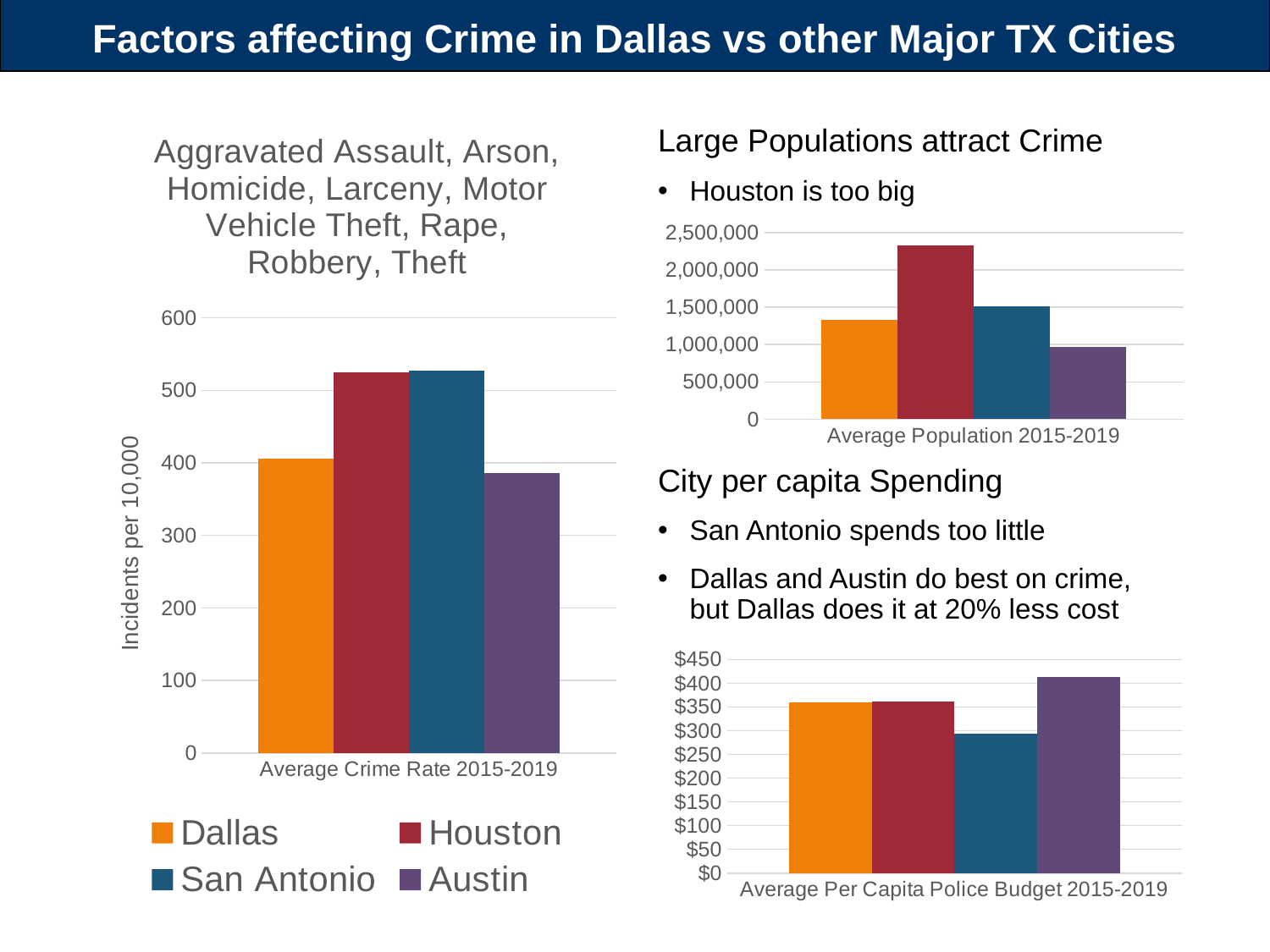
In the police budget chart (bottom right), which city has the highest average per capita police budget 2015-2019? Austin In the population chart (top right), which has the larger average population, San Antonio or Dallas? San Antonio In the population chart (top right), which city has the largest average population 2015-2019? Houston In the population chart (top right), is the value for Houston greater or less than 2,000,000? greater In the crime rate chart on the left, is the value for Austin greater or less than 400? less In the population chart (top right), which city has the smallest average population 2015-2019? Austin What kind of chart is the crime rate chart on the left? bar chart How many series does the legend on the left chart list? 4 In the police budget chart (bottom right), which city has the lowest average per capita police budget 2015-2019? San Antonio